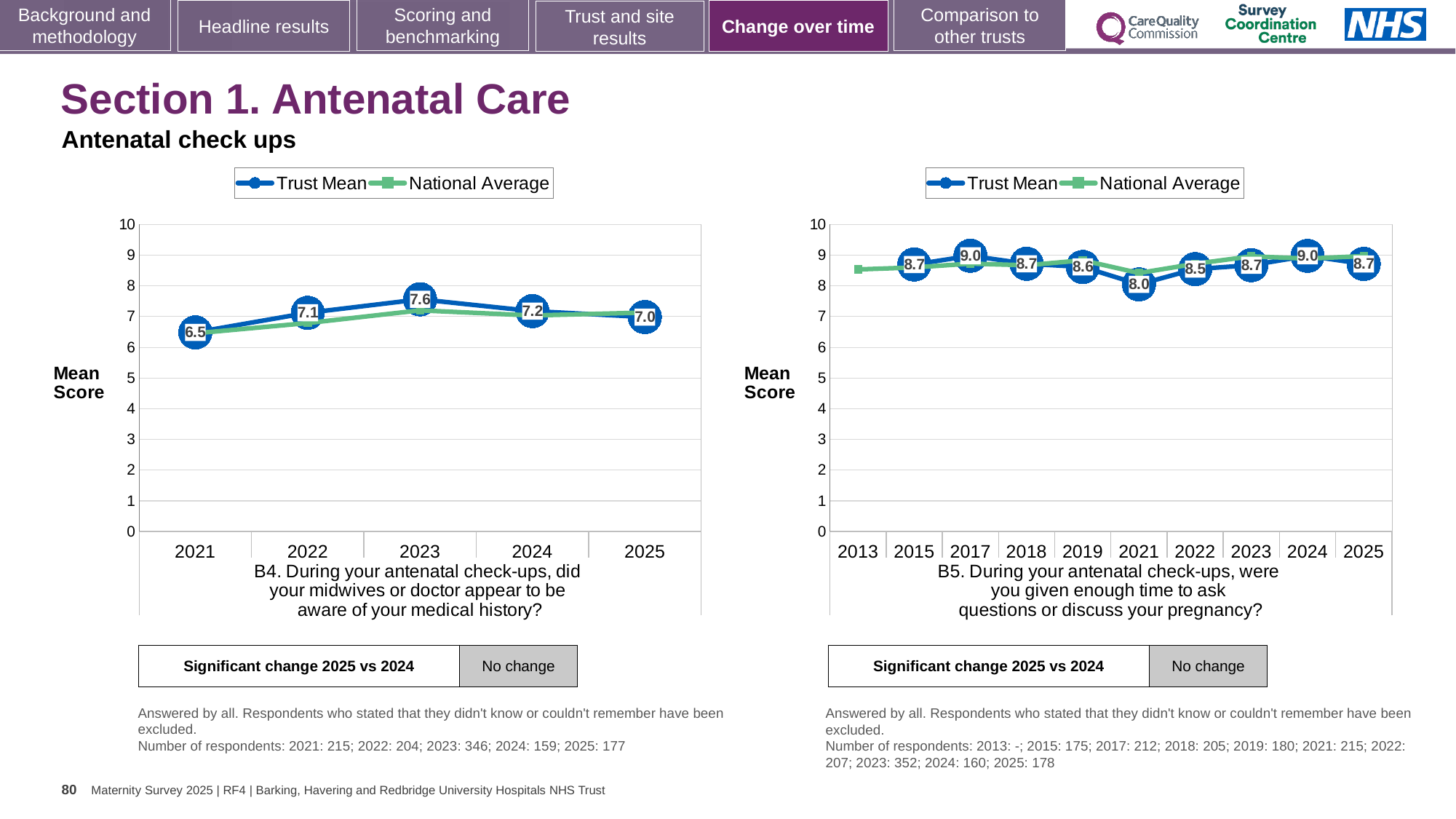
How many series does the legend of the left chart (B4) list? 2 On the left chart (B4), what is the Trust Mean score for 2023? 7.6 What kind of chart is the left chart (B4)? line chart On the right chart (B5), which is larger, the Trust Mean score for 2024 or for 2021? 2024 On the right chart (B5), what is the Trust Mean score for 2021? 8.0 How many years are shown on the x axis of the right chart (B5)? 10 On the right chart (B5), which year has the lowest Trust Mean score? 2021 On the left chart (B4), is the National Average value for 2021 greater or less than 7? less On the left chart (B4), what is the Trust Mean score for 2021? 6.5 On the left chart (B4), what is the difference between the Trust Mean scores for 2023 and 2021? 1.1 On the right chart (B5), what is the Trust Mean score for 2025? 8.7 On the left chart (B4), which year has the highest Trust Mean score? 2023